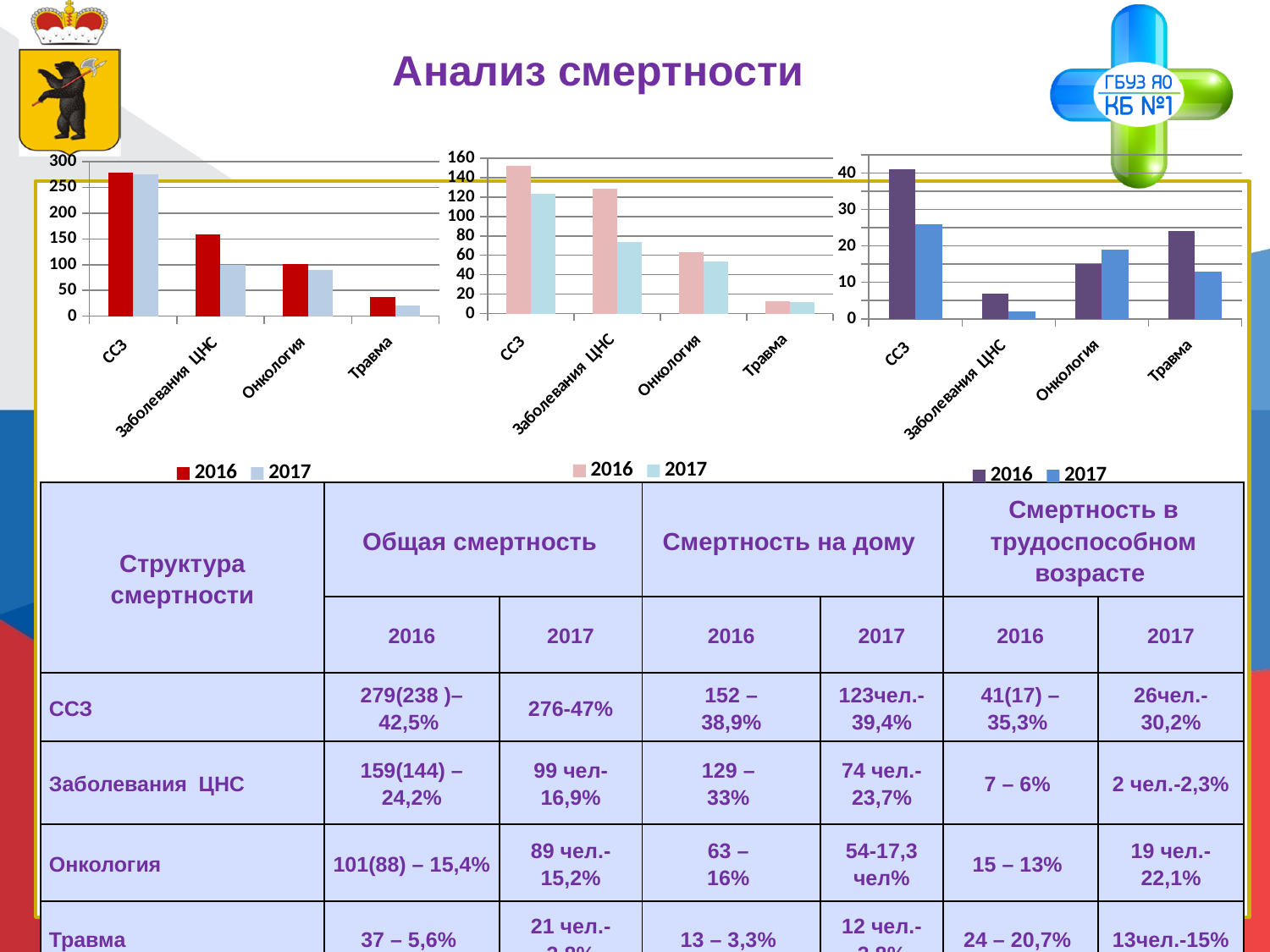
How many series does the legend of the right chart list? 2 In the right chart, which category has the lowest 2017 value? Заболевания ЦНС In the left chart, which category has the highest 2016 value? ССЗ In the right chart, which is larger for Травма, the 2016 value or the 2017 value? 2016 In the right chart, which is larger for Онкология, the 2016 value or the 2017 value? 2017 In the left chart, is the 2016 value for ССЗ greater or less than 250? greater What kind of chart is the left chart on the slide? bar chart How many categories are shown on the x axis of the middle chart? 4 In the middle chart, is the 2017 value for ССЗ greater or less than 100? greater In the left chart, do the 2016 values rise or fall from ССЗ to Травма along the x axis? fall In the left chart, which category has the lowest 2017 value? Травма In the right chart, is the 2017 value for Заболевания ЦНС greater or less than 10? less